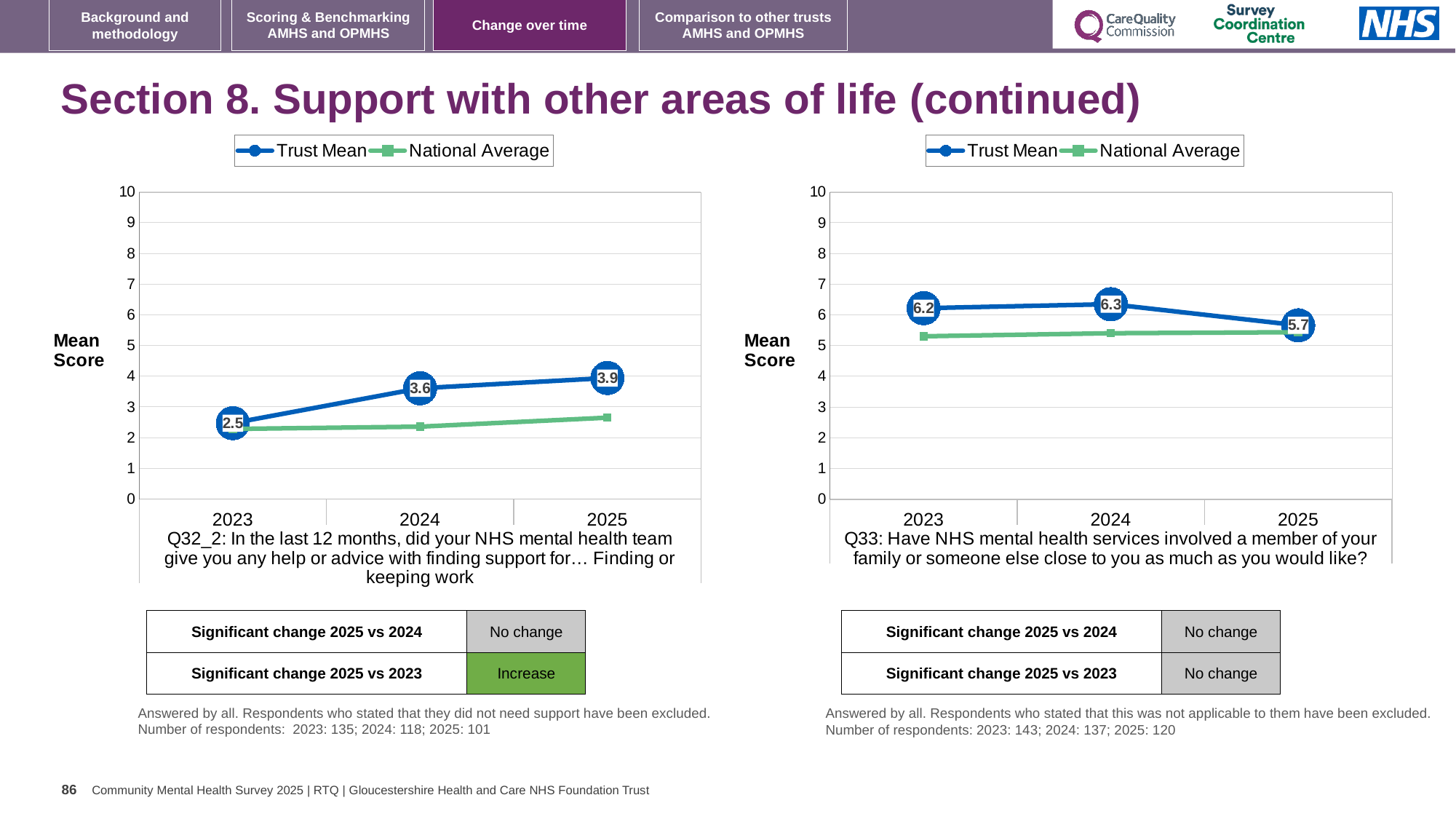
In the left chart (Q32_2), is the Trust Mean or the National Average higher in 2025? Trust Mean In the left chart (Q32_2), what is the Trust Mean for 2023? 2.5 In the right chart (Q33), what is the Trust Mean for 2024? 6.3 In the left chart (Q32_2), which year has the highest Trust Mean? 2025 In the left chart (Q32_2), by how much did the Trust Mean increase from 2023 to 2025? 1.4 In the right chart (Q33), is the National Average for 2023 greater or less than 5? greater In the right chart (Q33), what is the difference between the Trust Mean in 2024 and in 2025? 0.6 How many series does the legend of the right chart (Q33) list? 2 In the left chart (Q32_2), what is the Trust Mean for 2025? 3.9 In the right chart (Q33), what is the Trust Mean for 2025? 5.7 In the right chart (Q33), which year has the lowest Trust Mean? 2025 In the left chart (Q32_2), does the Trust Mean rise or fall from 2023 to 2025? rise